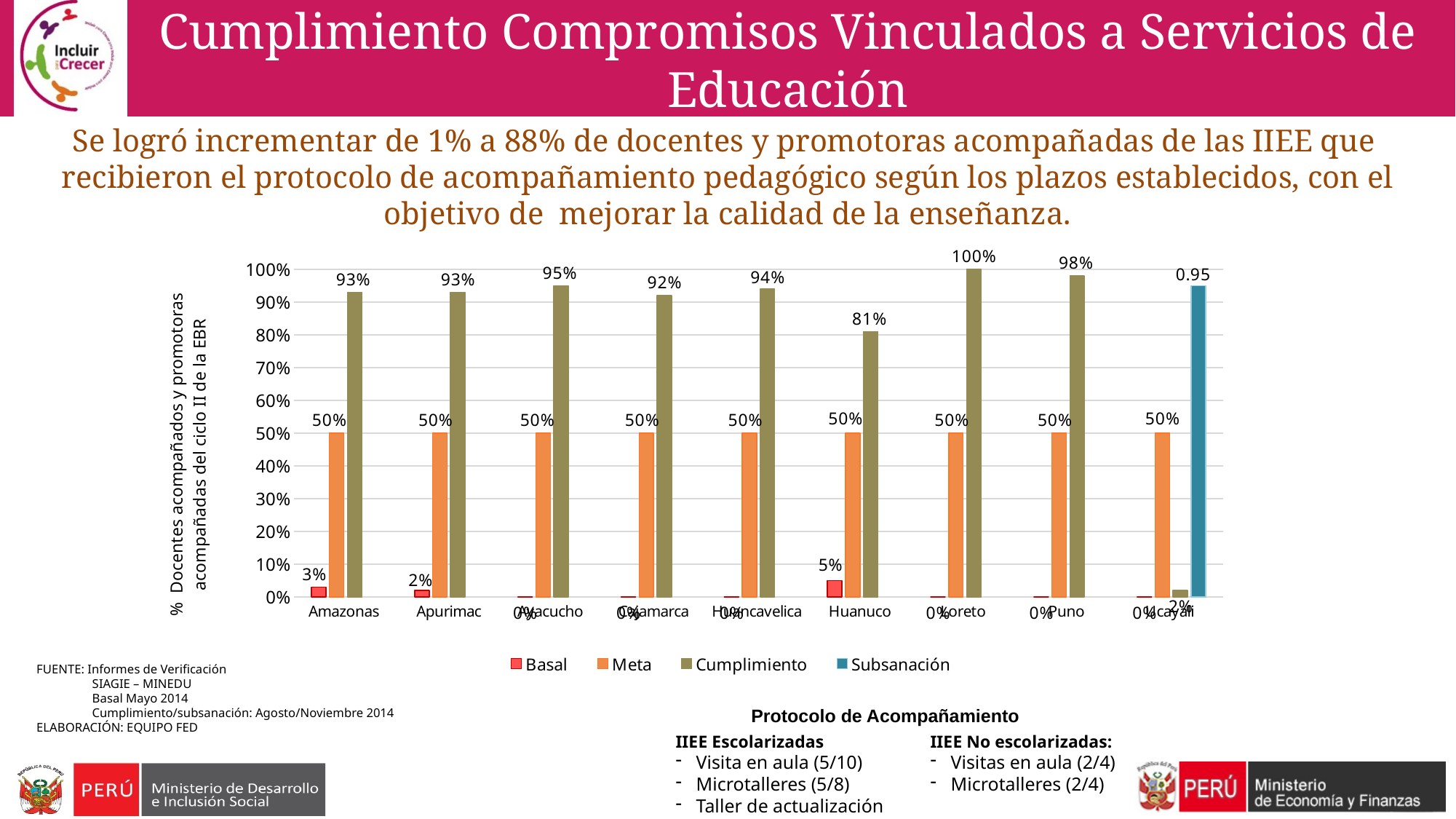
Which region has the lowest Cumplimiento value? Ucayali What is the Cumplimiento value for Huanuco? 81% How many regions are shown on the x axis of the chart? 9 What is the Basal value for Huanuco? 5% What is the difference between the Cumplimiento value for Puno and the Cumplimiento value for Huanuco? 17% What is the Subsanación value shown for Ucayali? 0.95 How many series does the chart legend list? 4 What kind of chart is shown on the slide? Bar chart Which is larger, the Cumplimiento value for Ayacucho or the Cumplimiento value for Cajamarca? Ayacucho Which region has the highest Cumplimiento value? Loreto What is the Meta value for Amazonas? 50% What is the Cumplimiento value for Loreto? 100%